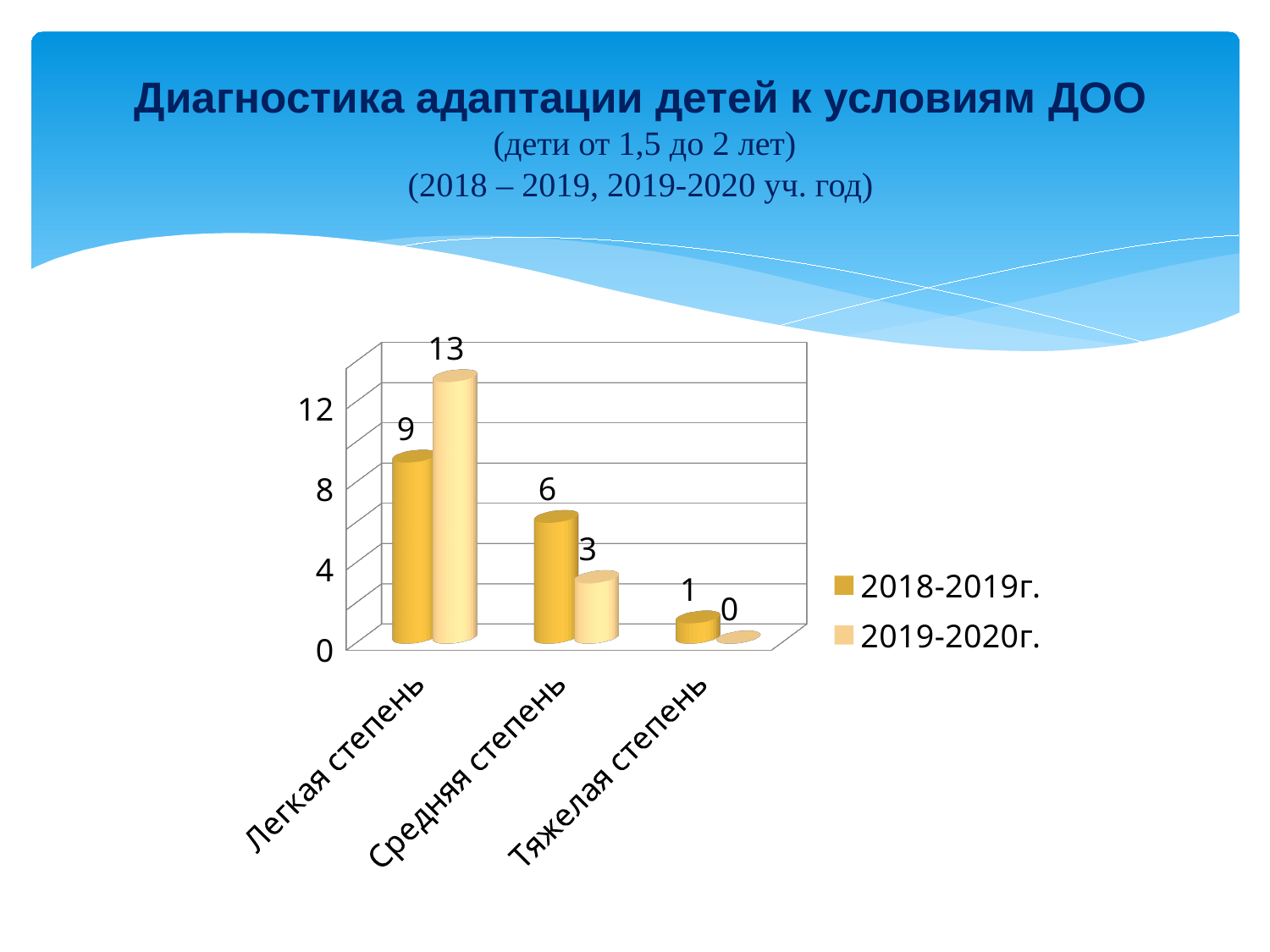
What is the difference between the 2019-2020г. and 2018-2019г. values for Легкая степень? 4 Do the values in the 2018-2019г. series rise or fall from Легкая степень to Тяжелая степень? Fall What kind of chart is shown on the slide? Bar chart What is the value for Средняя степень in the 2019-2020г. series? 3 Which series has the larger value for Средняя степень, 2018-2019г. or 2019-2020г.? 2018-2019г. What is the value for Легкая степень in the 2019-2020г. series? 13 How many categories are shown on the x axis? 3 Which category has the lowest value in the 2018-2019г. series? Тяжелая степень What is the value for Тяжелая степень in the 2018-2019г. series? 1 How many series does the legend list? 2 What is the value for Легкая степень in the 2018-2019г. series? 9 Which category has the highest value in the 2019-2020г. series? Легкая степень